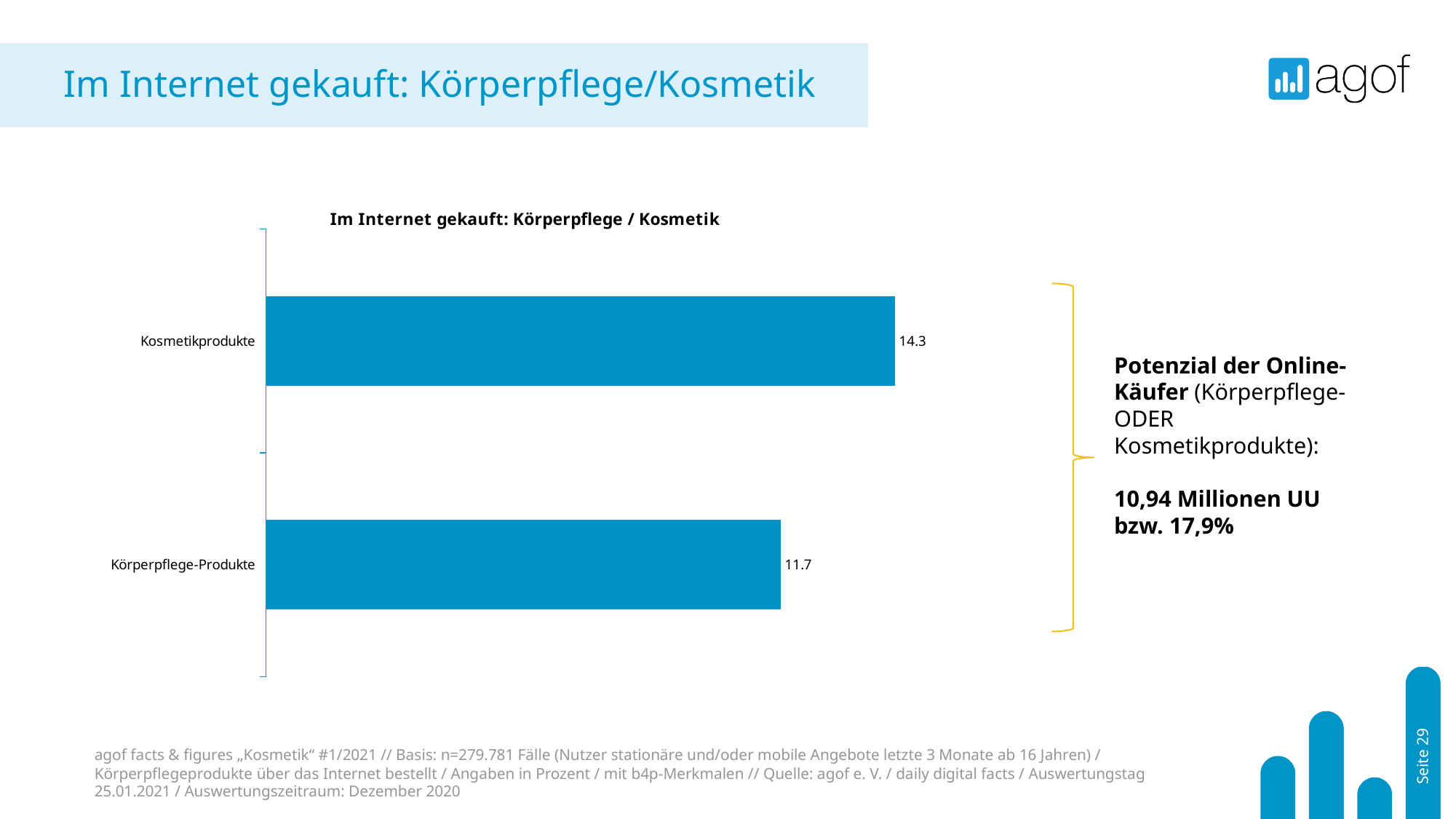
What is the title of the chart? Im Internet gekauft: Körperpflege / Kosmetik Which is larger, the value for Kosmetikprodukte or the value for Körperpflege-Produkte? Kosmetikprodukte Which category has the lowest value? Körperpflege-Produkte What colour are the bars in the chart? Blue Which category has the highest value? Kosmetikprodukte What is the value for Kosmetikprodukte? 14.3 What kind of chart is shown on the slide? Bar chart What is the difference between the values for Kosmetikprodukte and Körperpflege-Produkte? 2.6 What is the value for Körperpflege-Produkte? 11.7 How many categories are shown in the chart? 2